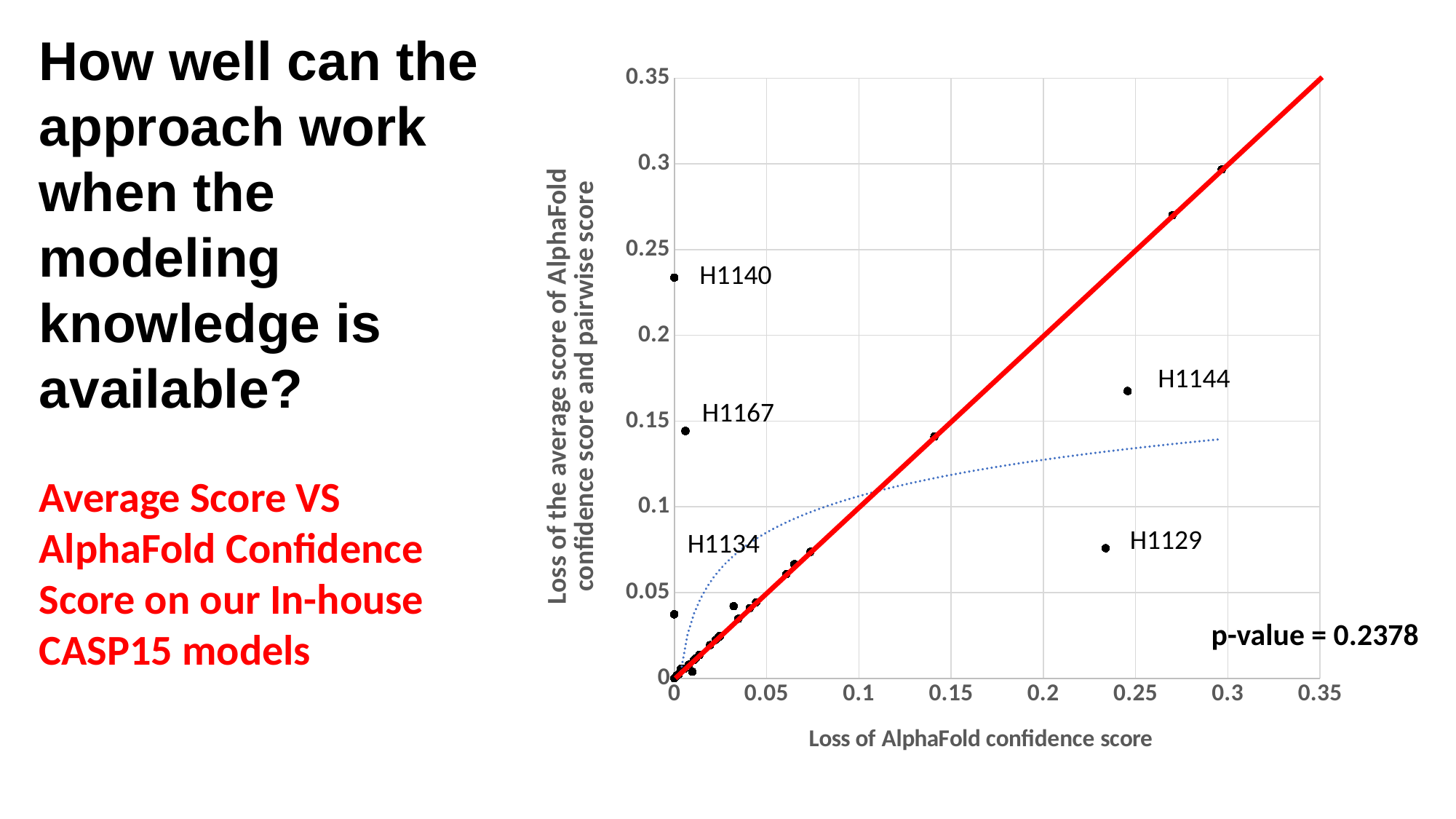
Which labeled point has the higher y-axis value, H1140 or H1144? H1140 Is the x-axis value for H1144 greater or less than 0.2? greater What kind of chart is shown on the slide? scatter plot Which labeled point has the higher y-axis value, H1144 or H1129? H1144 Is the y-axis value for H1129 greater or less than 0.1? less What is the title of the x axis of the chart? Loss of AlphaFold confidence score What p-value is printed on the chart? 0.2378 Is the x-axis value (loss of AlphaFold confidence score) for H1140 greater or less than 0.05? less Among the labeled points, which has the highest y-axis value? H1140 How many data points on the chart are labeled with a target name (such as H1140)? 5